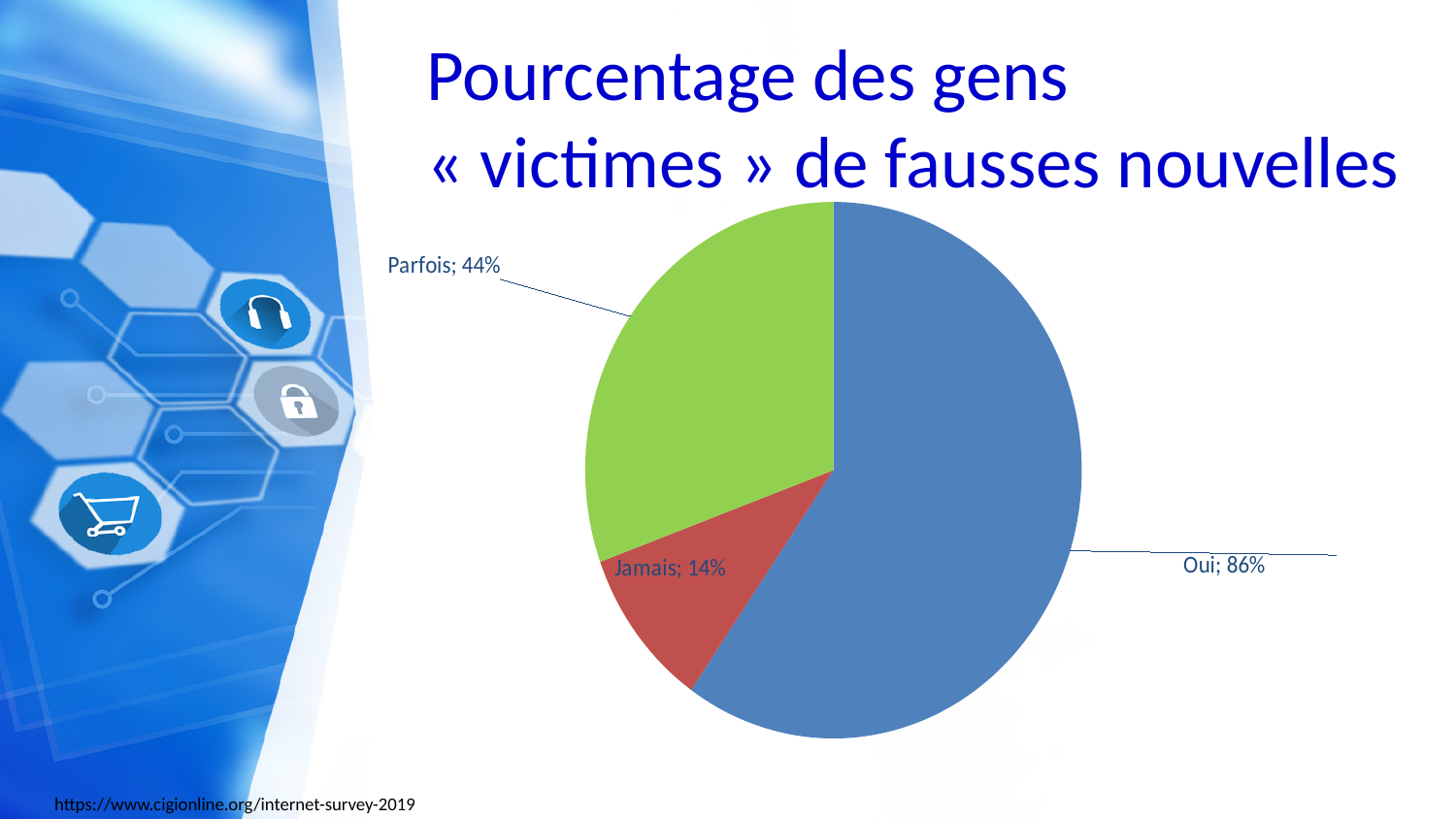
Which is larger, the value for "Parfois" or the value for "Jamais"? Parfois Which slice of the pie has the highest value? Oui What is the value shown for the "Jamais" slice? 14% Which slice of the pie has the lowest value? Jamais What is the value shown for the "Oui" slice? 86% What is the value shown for the "Parfois" slice? 44% What colour is the "Parfois" slice of the pie? green What is the difference between the values for "Oui" and "Jamais"? 72% What kind of chart is shown on the slide? pie chart What is the difference between the values for "Oui" and "Parfois"? 42% What share of the pie is labelled for the "Jamais" slice? 14% How many slices does the pie chart have? 3